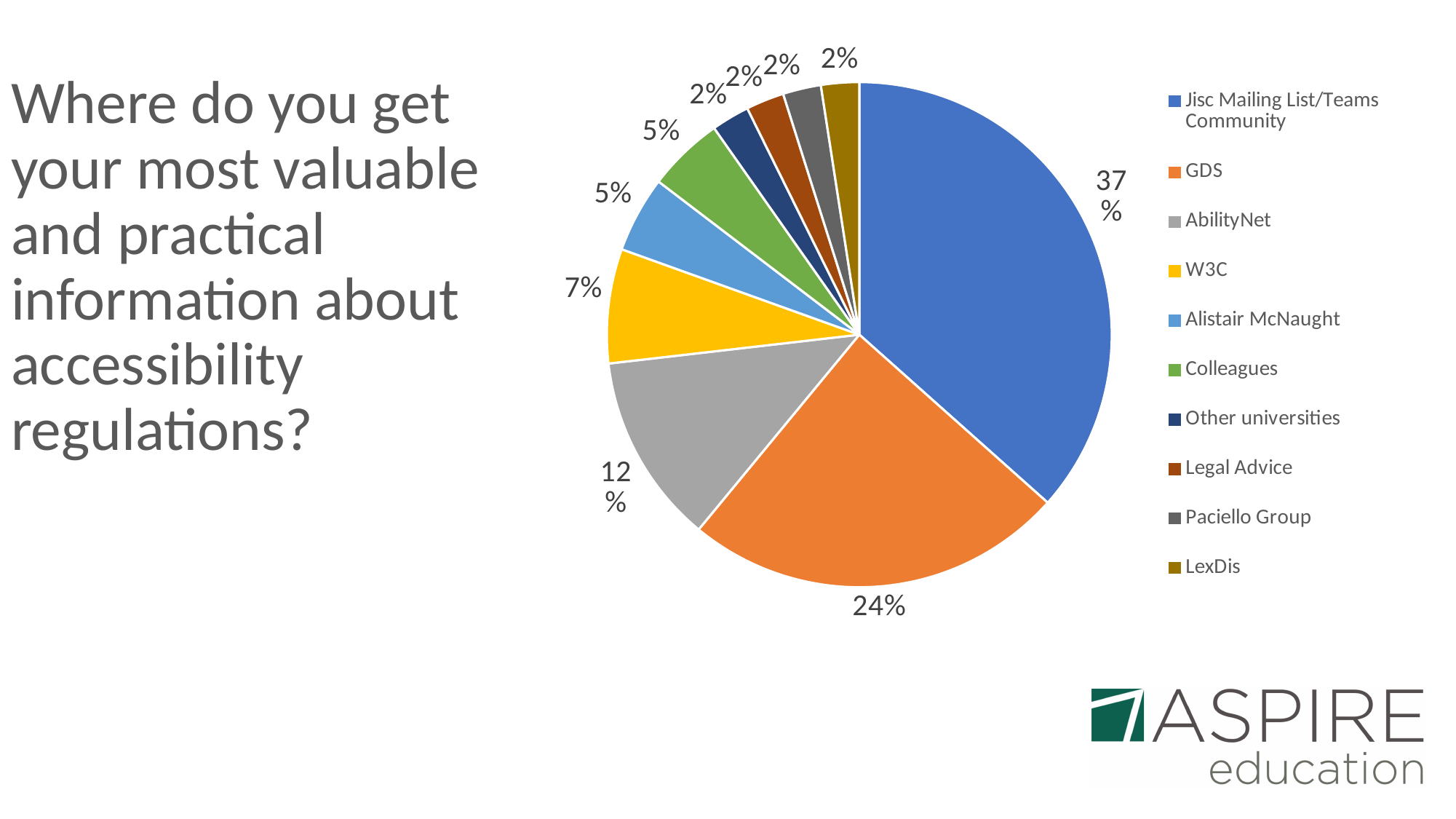
What share of the pie does LexDis have? 2% What share of the pie does Jisc Mailing List/Teams Community have? 37% What share of the pie does AbilityNet have? 12% What kind of chart is shown on the slide? pie chart Which slice is larger, AbilityNet or W3C? AbilityNet What colour is the GDS slice? orange How many categories does the legend list? 10 Which category has the largest slice of the pie? Jisc Mailing List/Teams Community What is the difference in percentage points between the Jisc Mailing List/Teams Community slice and the GDS slice? 13